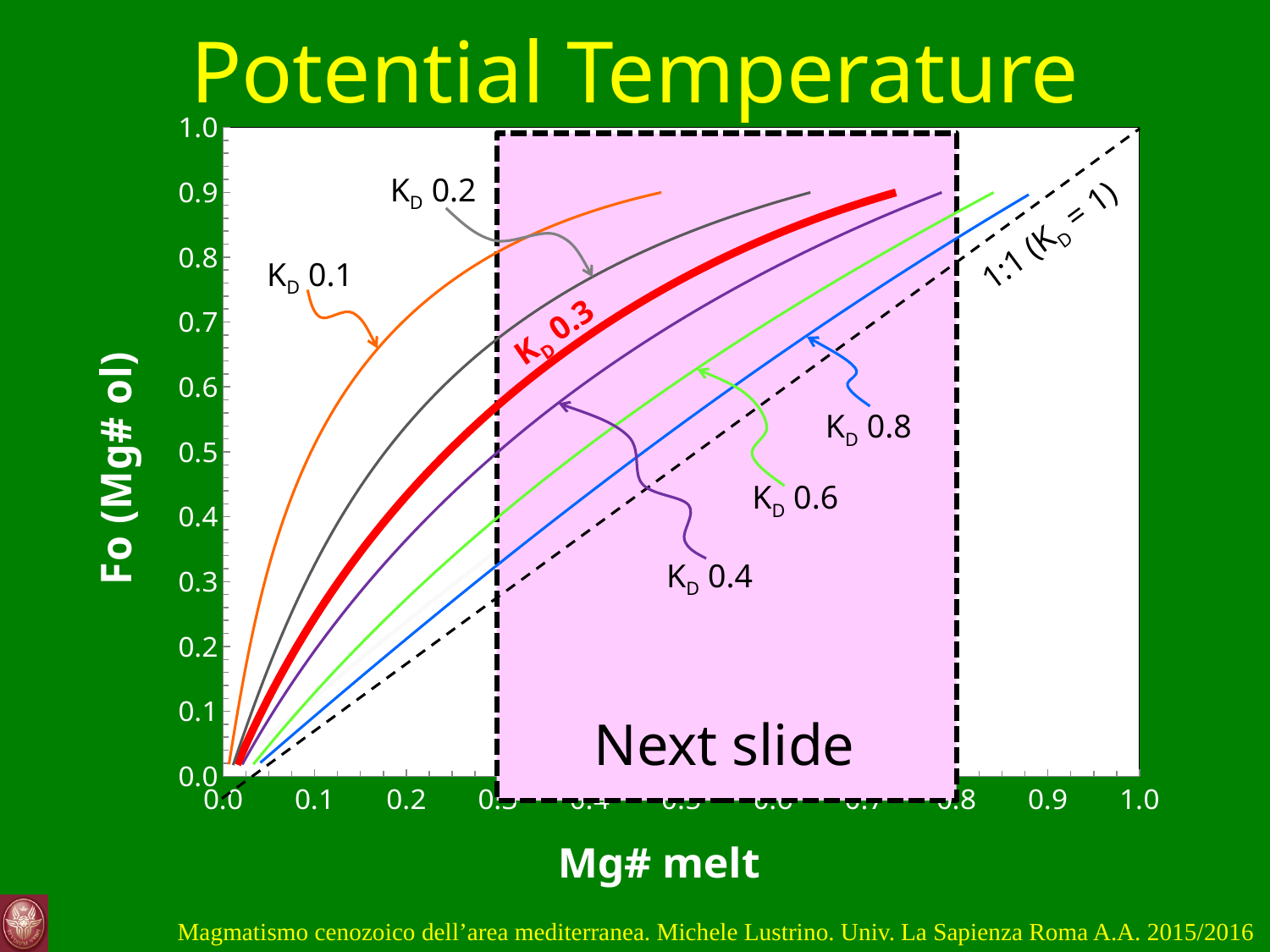
What is the title of the chart? Potential Temperature At Mg# melt 0.2, is the Fo value of the K_D 0.1 curve greater or less than 0.5? greater How many K_D values are labeled on the curves, not counting the 1:1 line? 6 As Mg# melt increases along the x axis, do the curves rise or fall? rise What kind of chart is shown on the slide? line chart At Mg# melt 0.3, is the Fo value of the K_D 0.8 curve greater or less than 0.4? less Which K_D curve is drawn as the thick red line? K_D 0.3 At Mg# melt 0.2, which curve has the higher Fo value, K_D 0.1 or K_D 0.8? K_D 0.1 Which labeled K_D curve lies highest on the chart (furthest above the 1:1 line)? K_D 0.1 What K_D value does the dashed 1:1 line correspond to? 1 At Mg# melt 0.5, is the Fo value of the K_D 0.3 curve greater or less than 0.6? greater Which labeled K_D curve lies lowest on the chart (closest to the 1:1 line)? K_D 0.8